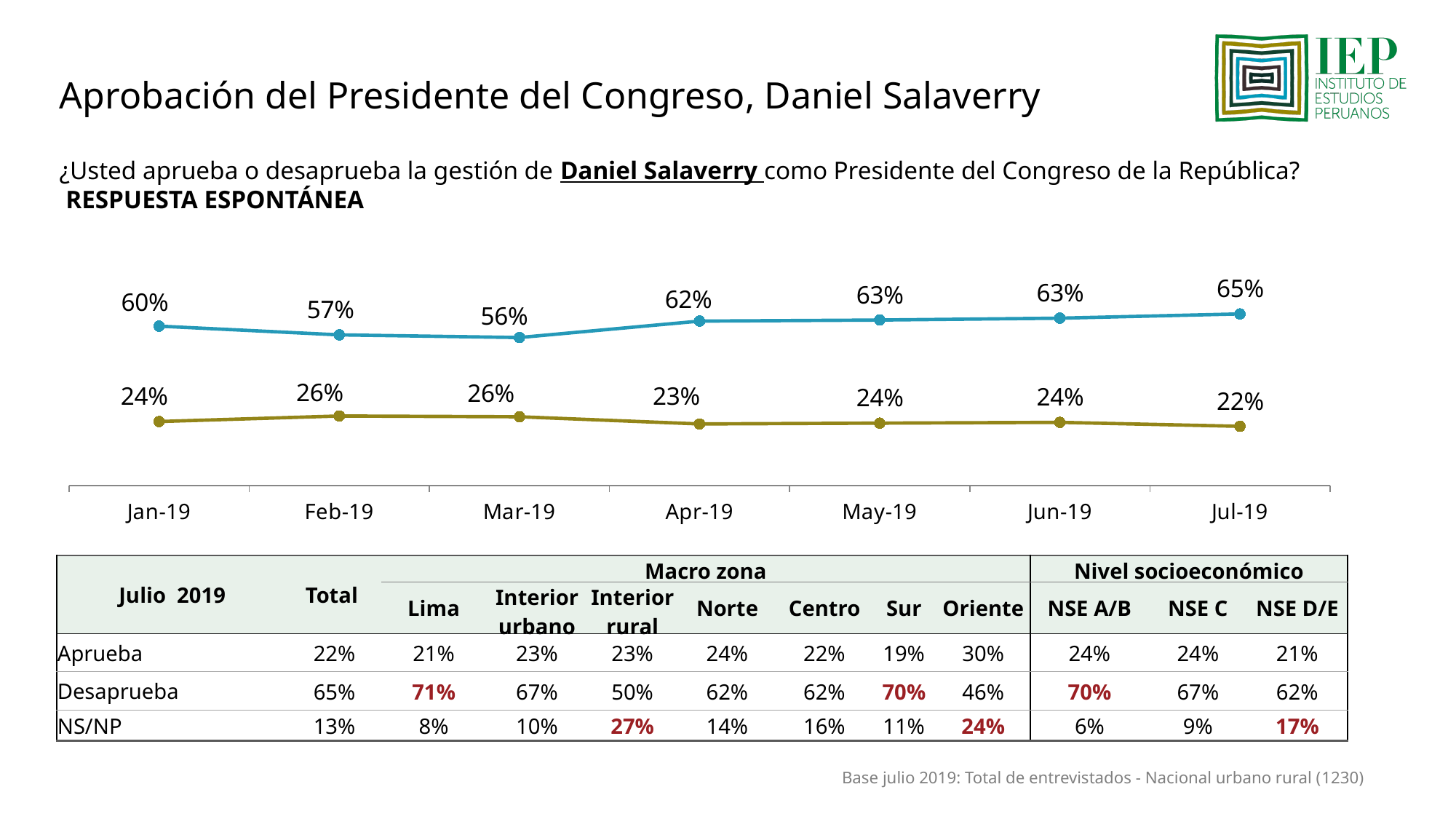
How many months are plotted along the x axis of the line chart? 7 What is the value of the upper (blue) line in Jul-19? 65% In which month does the upper (blue) line reach its lowest value? Mar-19 In which month does the upper (blue) line reach its highest value? Jul-19 By how much did the upper (blue) line change from Mar-19 to Apr-19? 6% Which is larger in Apr-19: the upper (blue) line or the lower (olive) line? the upper (blue) line What is the value of the upper (blue) line in Jan-19? 60% What is the value of the lower (olive) line in Feb-19? 26% What is the difference between the upper (blue) line and the lower (olive) line in Jul-19? 43% What type of chart is shown on the slide? line chart From Apr-19 to Jul-19, does the upper (blue) line rise or fall overall? rise In which month does the lower (olive) line reach its lowest value? Jul-19